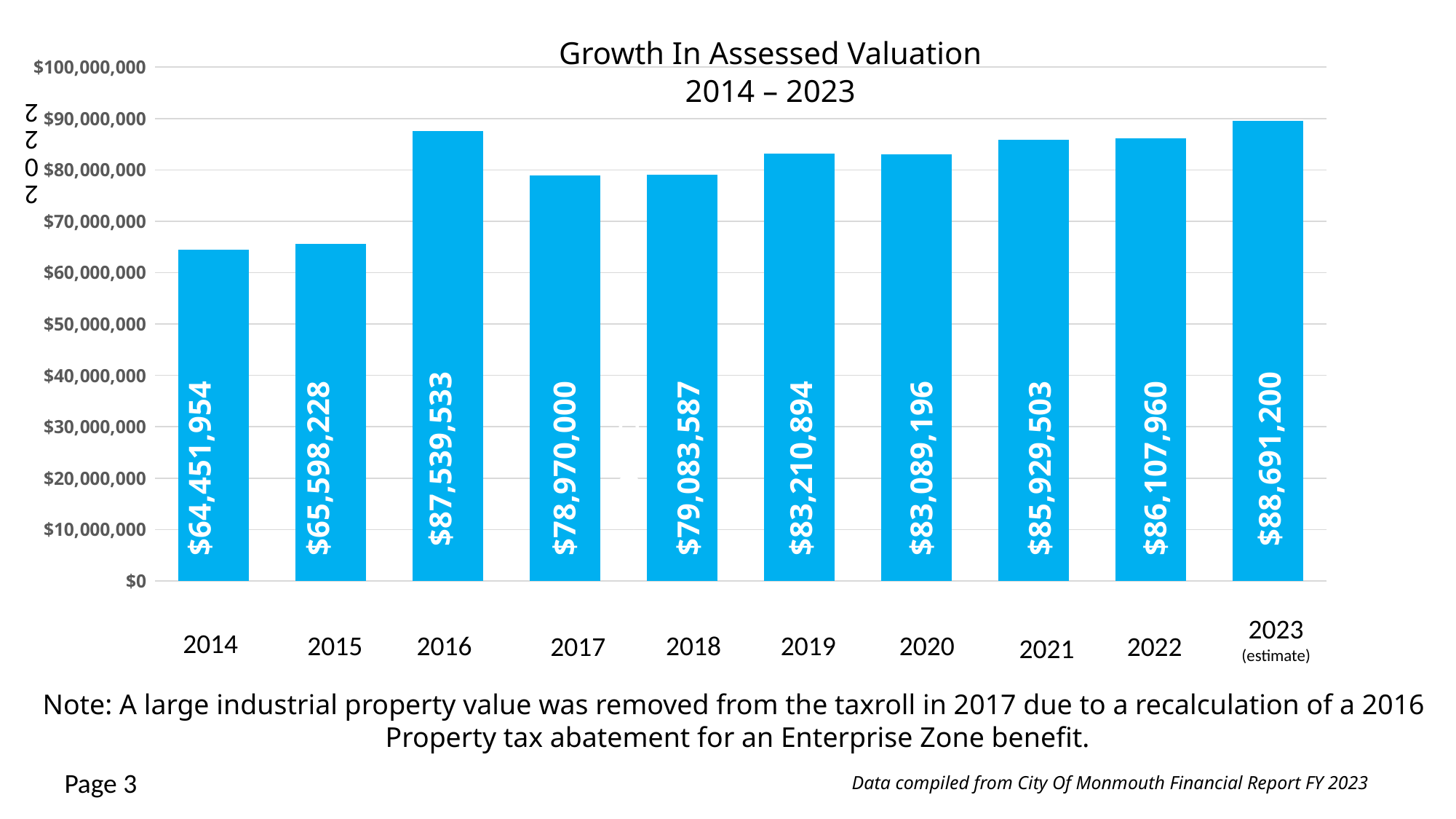
What kind of chart is shown on the slide? Bar chart Which year has the larger assessed valuation, 2016 or 2017? 2016 What is the assessed valuation for 2016? $87,539,533 Do the assessed valuations rise or fall from 2017 to 2023? Rise What is the assessed valuation for 2020? $83,089,196 Is the value for 2014 greater or less than $70,000,000? less Which year has the lowest assessed valuation? 2014 How many years are shown on the chart? 10 What is the difference between the 2015 and 2014 assessed valuations? $1,146,274 Which year has the highest assessed valuation? 2023 (estimate) What is the difference between the 2016 and 2017 assessed valuations? $8,569,533 What is the estimated assessed valuation for 2023? $88,691,200